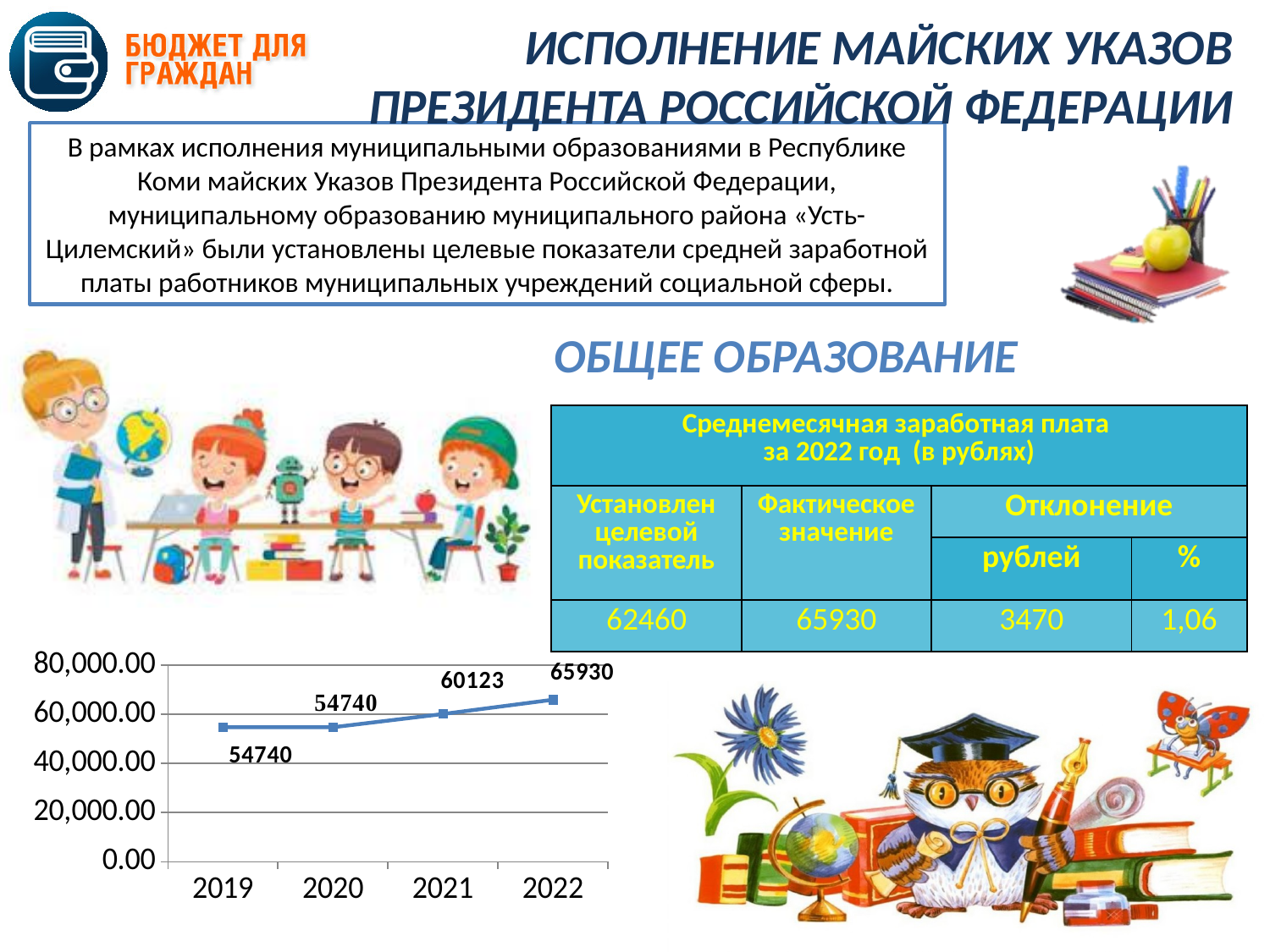
What type of chart is shown at the bottom left of the slide? line chart How many years are plotted on the x axis of the line chart? 4 What is the difference between the 2021 and 2020 values in the line chart? 5383 What is the value plotted for 2022 in the line chart? 65930 What is the difference between the 2022 and 2021 values in the line chart? 5807 What is the value plotted for 2021 in the line chart? 60123 Which year has the highest value in the line chart? 2022 In the line chart, is the value for 2022 larger than the value for 2020? yes Is the value for 2019 in the line chart greater or less than 60,000.00? less What is the value plotted for 2019 in the line chart? 54740 What is the highest tick label on the y axis of the line chart? 80,000.00 Do the values in the line chart rise or fall from 2020 to 2022? rise